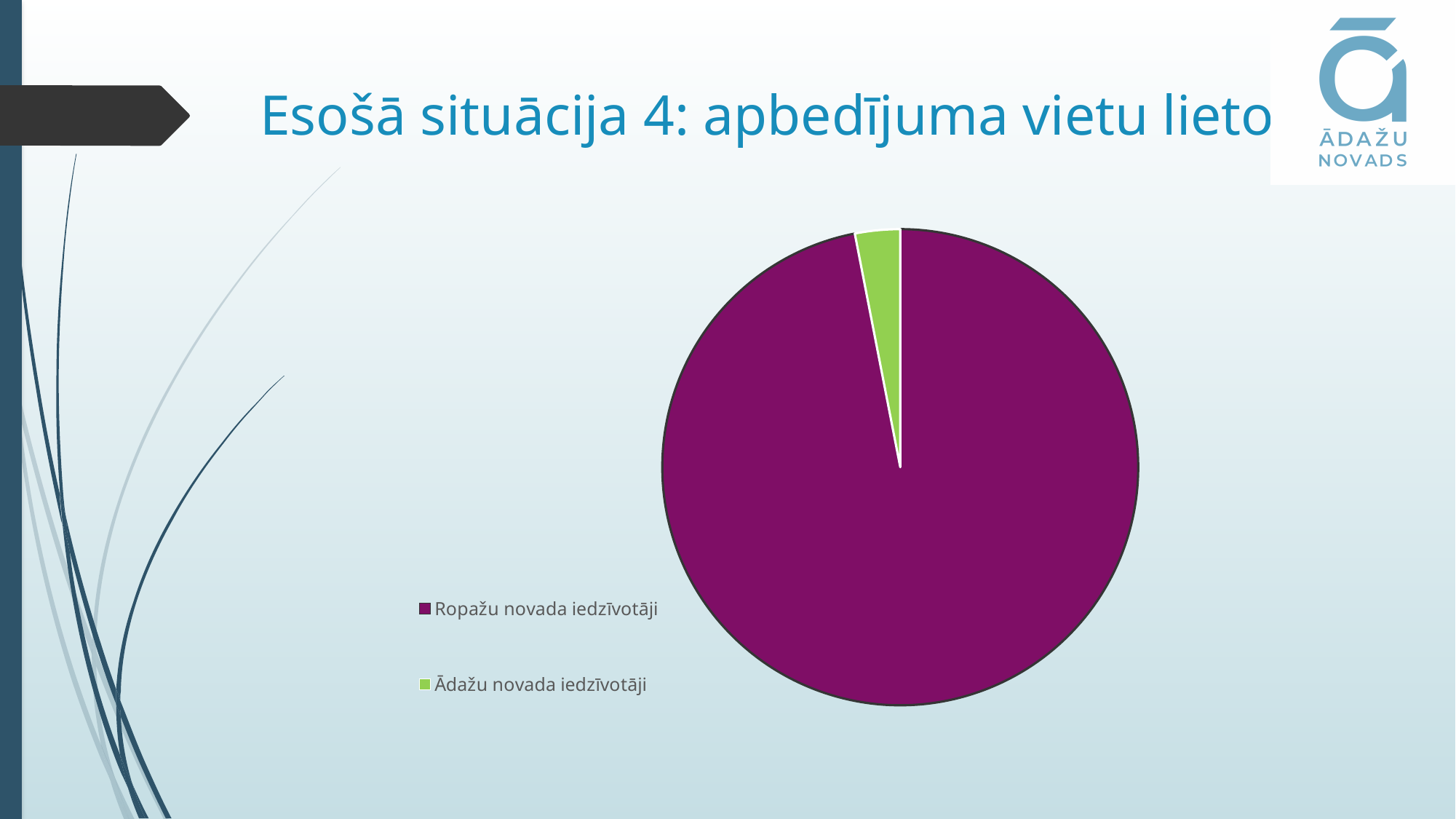
Which category has the smallest slice of the pie chart? Ādažu novada iedzīvotāji Which slice is larger: Ropažu novada iedzīvotāji or Ādažu novada iedzīvotāji? Ropažu novada iedzīvotāji Which category has the largest slice of the pie chart? Ropažu novada iedzīvotāji What kind of chart is shown on the slide? pie chart What colour is the slice for Ropažu novada iedzīvotāji? purple How many slices does the pie chart have? 2 What colour is the slice for Ādažu novada iedzīvotāji? green How many entries does the legend of the pie chart list? 2